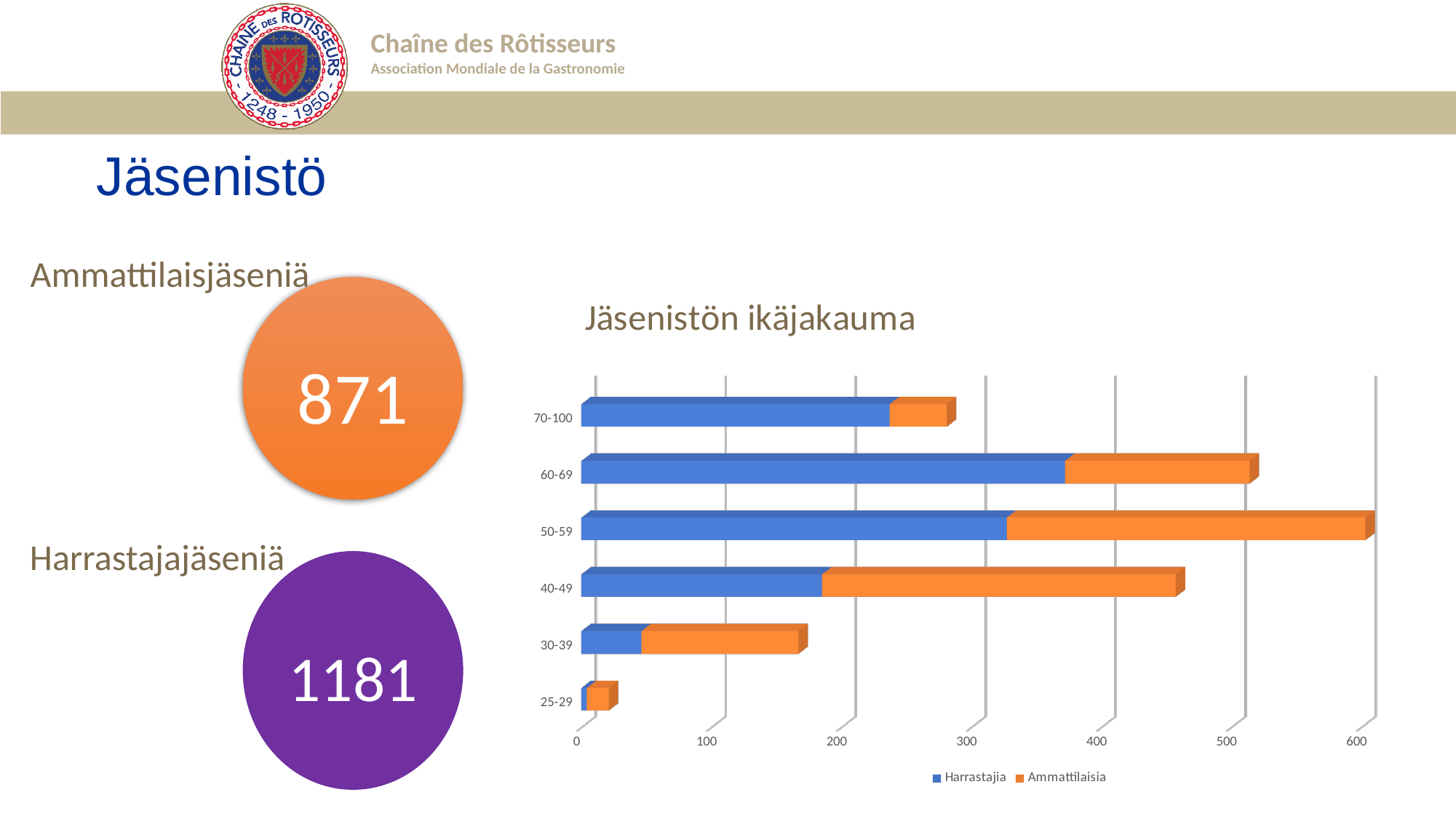
What kind of chart is 'Jäsenistön ikäjakauma'? bar chart In the 'Jäsenistön ikäjakauma' chart, is the total bar for 30-39 greater or less than 200? less In the 'Jäsenistön ikäjakauma' chart, is the total bar for 70-100 greater or less than 300? less Which colour represents the Ammattilaisia series in the 'Jäsenistön ikäjakauma' chart? orange In the 'Jäsenistön ikäjakauma' chart, which age group has the shortest total bar? 25-29 How many series does the legend of the 'Jäsenistön ikäjakauma' chart list? 2 In the 'Jäsenistön ikäjakauma' chart, which age group has the longest total bar? 50-59 In the 'Jäsenistön ikäjakauma' chart, which age group has the larger Ammattilaisia value, 30-39 or 70-100? 30-39 How many age groups are shown in the 'Jäsenistön ikäjakauma' chart? 6 In the 'Jäsenistön ikäjakauma' chart, is the total bar for 60-69 greater or less than 500? greater In the 'Jäsenistön ikäjakauma' chart, which has the longer total bar, 60-69 or 40-49? 60-69